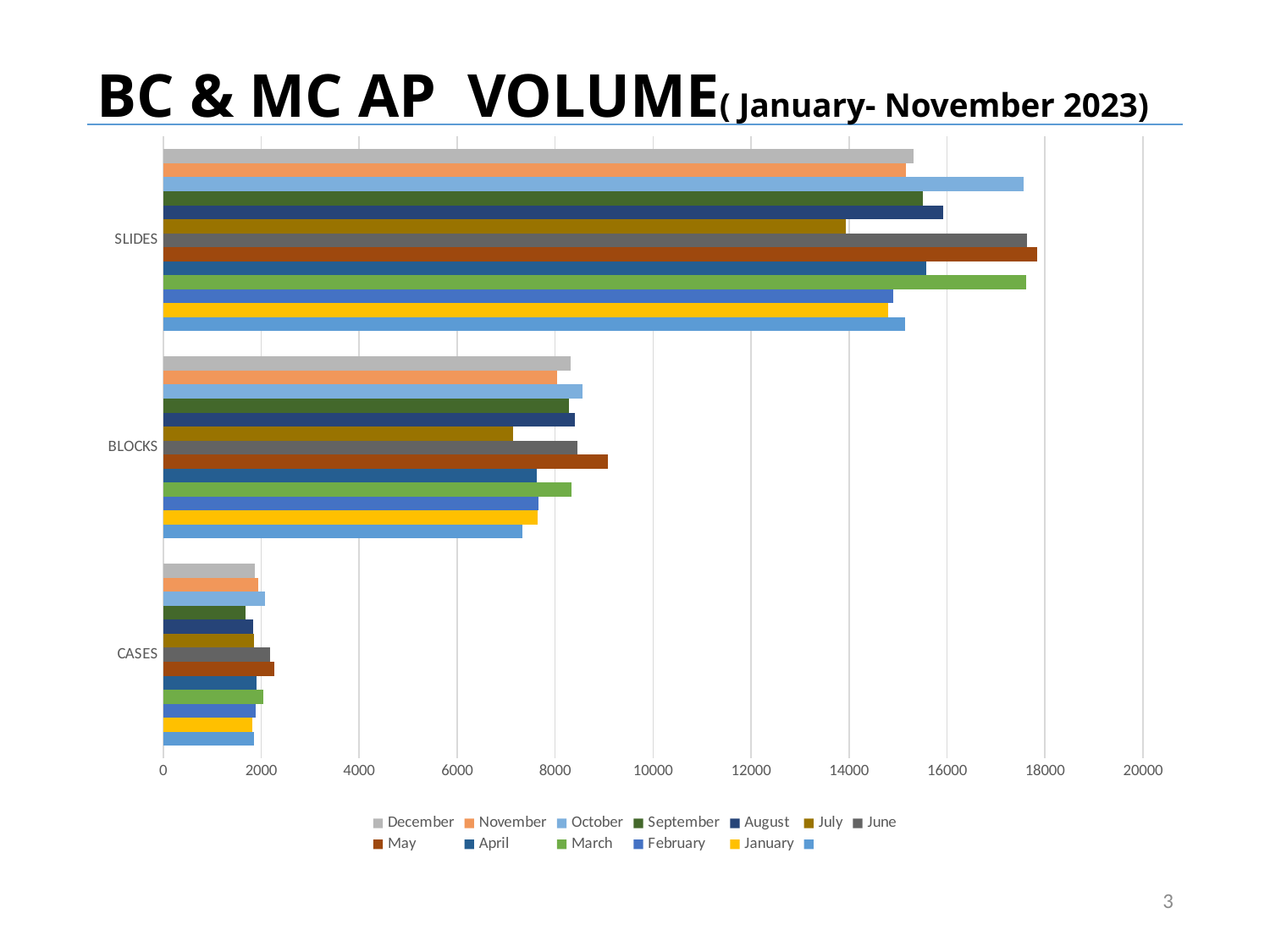
Which month has the highest value in the BLOCKS category? May Is the value for May in the CASES category greater or less than 4000? less How many categories are shown on the vertical axis of the chart? 3 Which category has the shortest bars in the chart? CASES Is the value for May in the BLOCKS category greater or less than 8000? greater Is the value for July in the BLOCKS category greater or less than 8000? less What is the title of the chart on the slide? BC & MC AP VOLUME (January- November 2023) Which category has the longest bars in the chart? SLIDES What kind of chart is shown on the slide? bar chart How many named months does the chart's legend list? 12